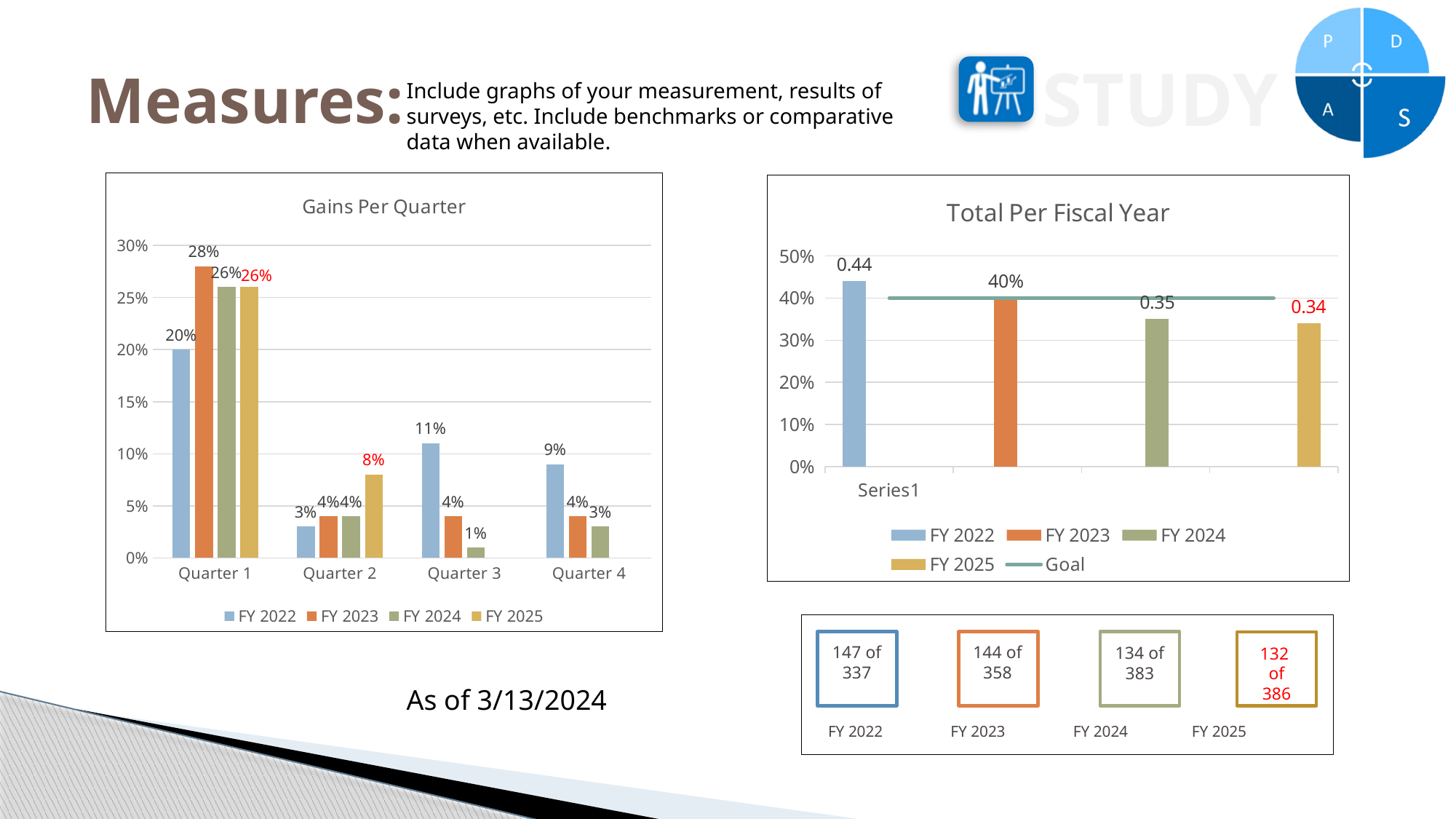
In the Total Per Fiscal Year chart, what is the value labelled for FY 2022? 0.44 In the Gains Per Quarter chart, what is the value for FY 2025 in Quarter 2? 8% In the Gains Per Quarter chart, what is the difference between the FY 2022 and FY 2024 values in Quarter 4? 6% In the Total Per Fiscal Year chart, what is the value labelled for FY 2025? 0.34 In the Gains Per Quarter chart, what is the value for FY 2023 in Quarter 1? 28% In the Gains Per Quarter chart, how many quarters are shown on the x axis? 4 In the Gains Per Quarter chart, what is the value for FY 2022 in Quarter 3? 11% In the Gains Per Quarter chart, how many series does the legend list? 4 In the Gains Per Quarter chart, which series has the highest value in Quarter 1? FY 2023 In the Gains Per Quarter chart, which series has the lowest value in Quarter 3? FY 2024 What kind of chart is the Total Per Fiscal Year chart? Bar chart with a goal line In the Total Per Fiscal Year chart, which fiscal year has the highest bar? FY 2022